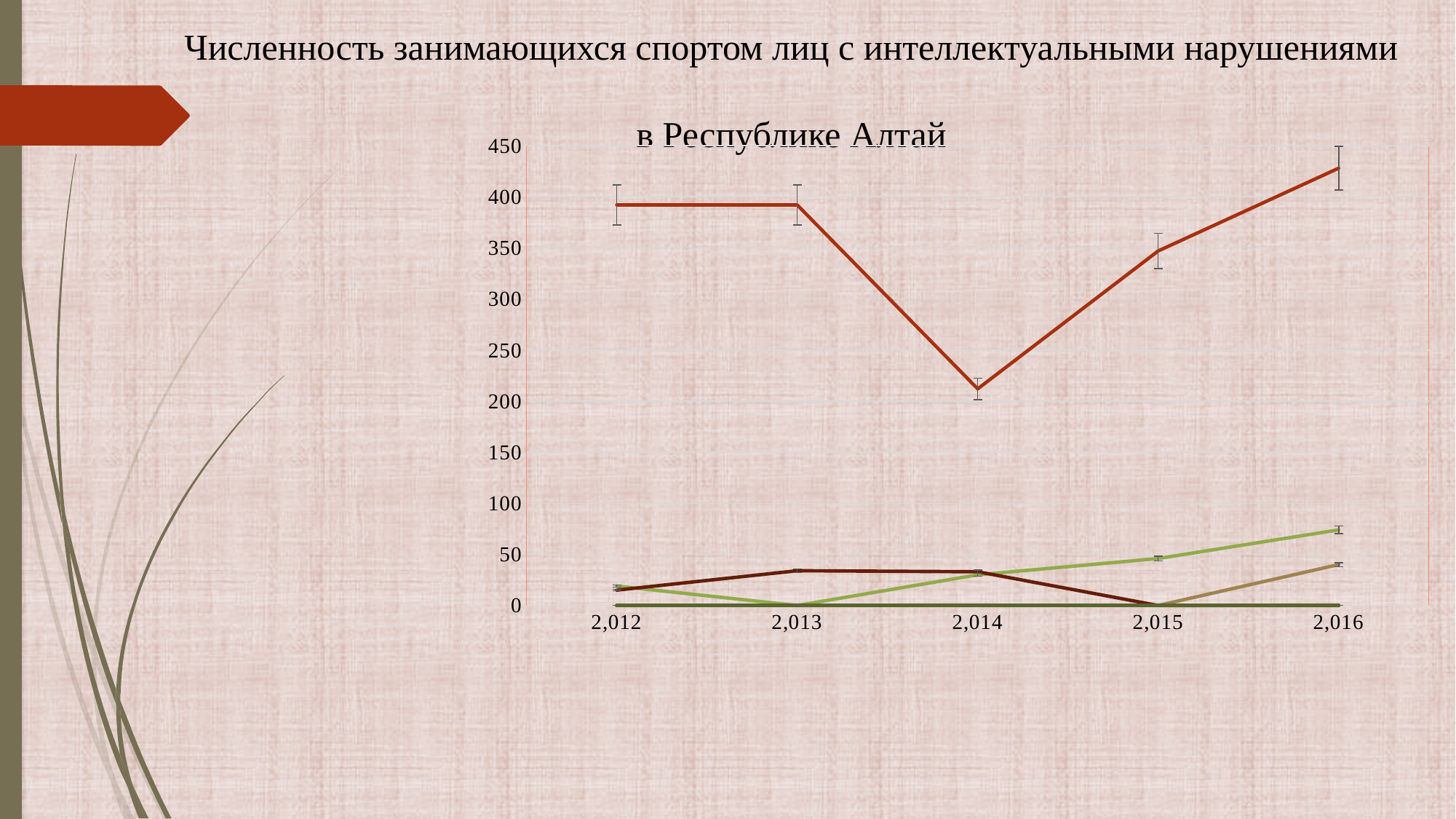
Which year has the lowest value on the red (top) line? 2,014 On the red line, which is larger: the value for 2,016 or the value for 2,012? 2,016 Is the value of the light green line for 2,016 greater or less than 50? greater How many years are shown on the x axis? 5 Does the red line rise or fall from 2,014 to 2,016? rise Is the value of the red line for 2,014 greater or less than 250? less Is the value of the red line for 2,013 greater or less than 300? greater What kind of chart is shown on the slide? line chart What is the first year shown on the x axis? 2,012 Which year has the highest value on the red (top) line? 2,016 What is the title of the chart? Численность занимающихся спортом лиц с интеллектуальными нарушениями в Республике Алтай